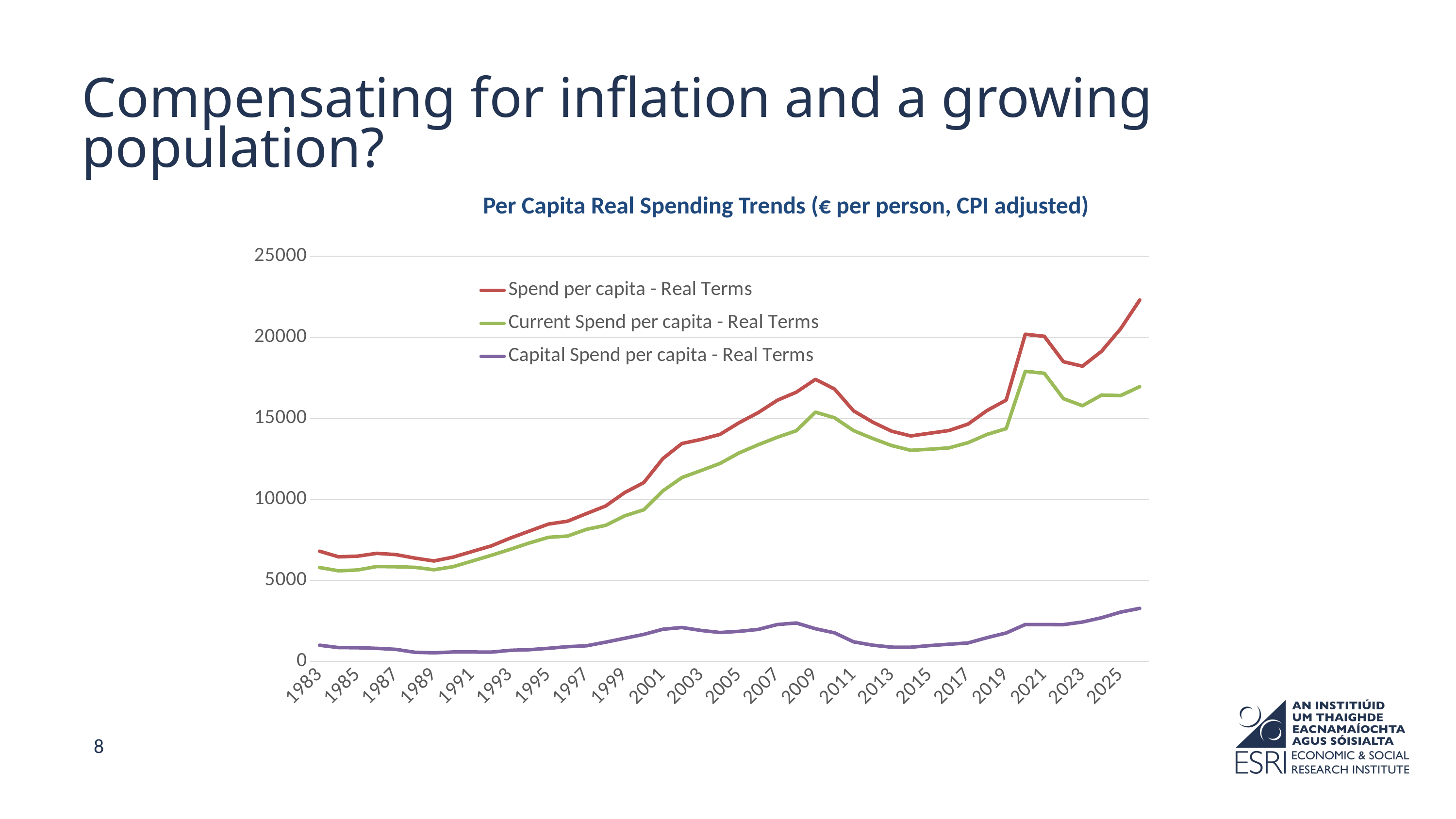
In 2009, which is larger: Spend per capita - Real Terms or Capital Spend per capita - Real Terms? Spend per capita - Real Terms What is the title of the chart? Per Capita Real Spending Trends (€ per person, CPI adjusted) Is the value for Spend per capita - Real Terms in 2009 greater or less than 15000? greater Does Spend per capita - Real Terms rise or fall overall from 1983 to 2025? rise Which series has the highest values across the chart? Spend per capita - Real Terms Which series is shown by the purple line? Capital Spend per capita - Real Terms Is the value for Spend per capita - Real Terms in 1983 greater or less than 5000? greater Which series has the lowest values across the chart? Capital Spend per capita - Real Terms How many series does the legend list? 3 What kind of chart is shown on the slide? line chart Is the value for Capital Spend per capita - Real Terms in 2025 greater or less than 5000? less